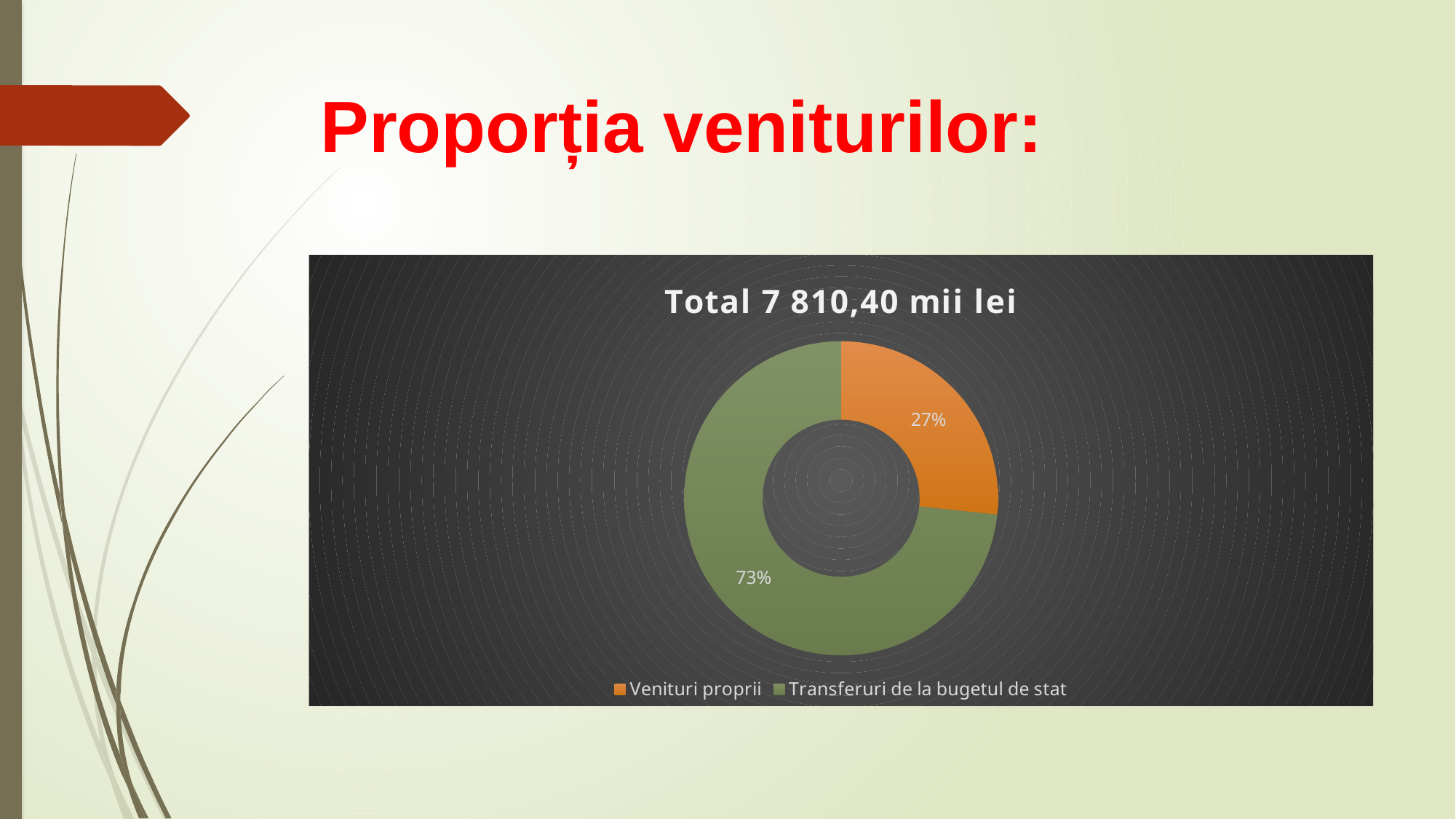
How many categories are shown in the chart? 2 What is the difference in percentage points between Transferuri de la bugetul de stat and Venituri proprii? 46 What is the title of the chart? Total 7 810,40 mii lei What kind of chart is shown on the slide? Doughnut (pie) chart Which category has the largest share of the chart? Transferuri de la bugetul de stat Which category has the smallest share of the chart? Venituri proprii What share of the chart does Transferuri de la bugetul de stat represent? 73% What share of the chart does Venituri proprii represent? 27% Which colour represents Venituri proprii in the chart? Orange Which is larger, the share for Venituri proprii or the share for Transferuri de la bugetul de stat? Transferuri de la bugetul de stat